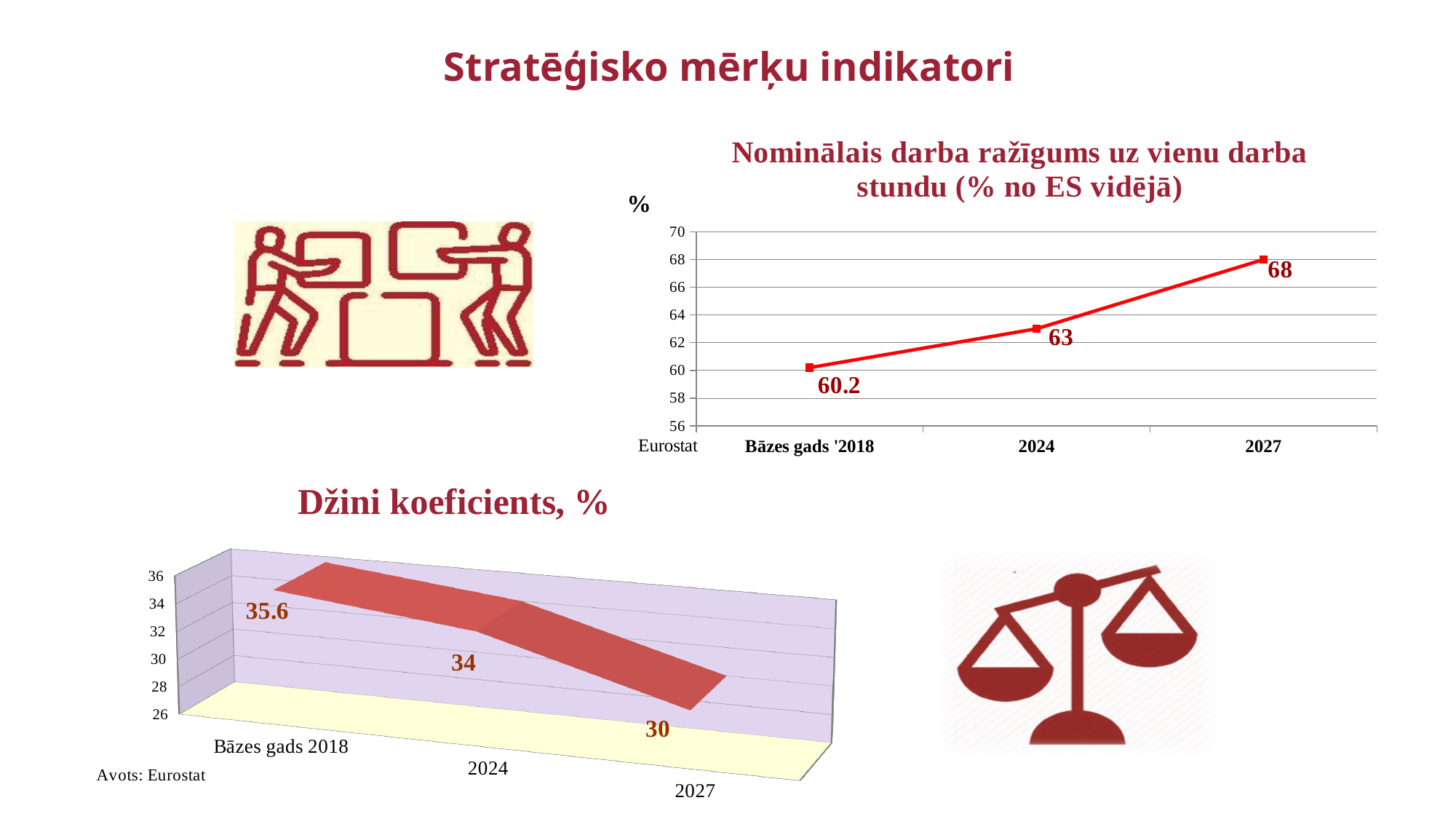
In the chart 'Nominālais darba ražīgums uz vienu darba stundu (% no ES vidējā)', which year has the highest value? 2027 What kind of chart is 'Nominālais darba ražīgums uz vienu darba stundu (% no ES vidējā)'? line chart In the chart 'Džini koeficients, %', what is the value for 2027? 30 In the chart 'Džini koeficients, %', which year has the lowest value? 2027 In the chart 'Nominālais darba ražīgums uz vienu darba stundu (% no ES vidējā)', what is the difference between the 2027 value and the 2024 value? 5 In the chart 'Nominālais darba ražīgums uz vienu darba stundu (% no ES vidējā)', what is the value for Bāzes gads '2018? 60.2 In the chart 'Nominālais darba ražīgums uz vienu darba stundu (% no ES vidējā)', what is the value for 2024? 63 In the chart 'Džini koeficients, %', what is the difference between the 2018 value and the 2024 value? 1.6 How many data points are plotted in the chart 'Džini koeficients, %'? 3 In the chart 'Džini koeficients, %', do the values rise or fall from 2018 to 2027? fall In the chart 'Džini koeficients, %', what is the value for Bāzes gads 2018? 35.6 In the chart 'Nominālais darba ražīgums uz vienu darba stundu (% no ES vidējā)', do the values rise or fall from 2018 to 2027? rise